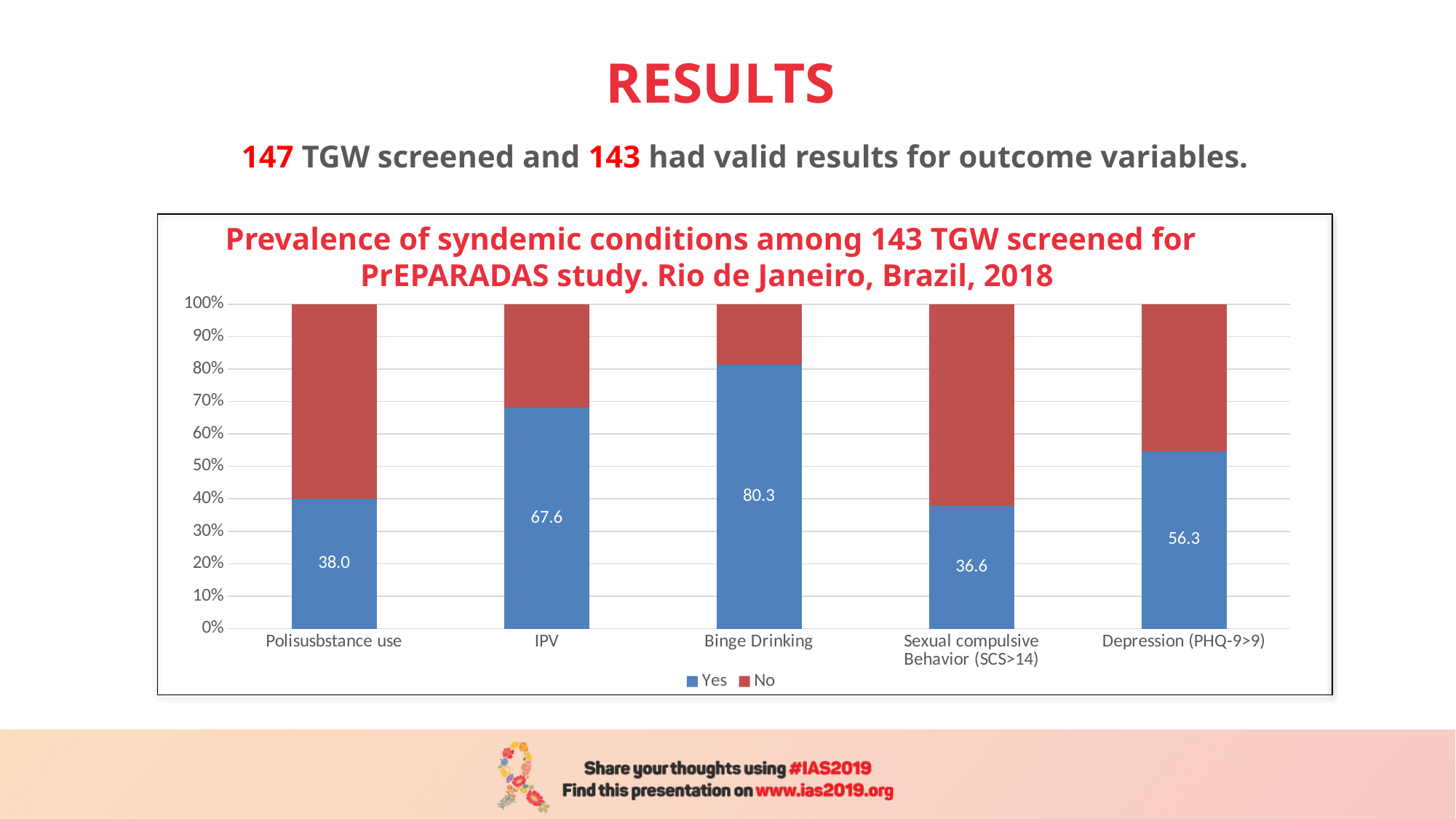
What is the 'Yes' value for Depression (PHQ-9>9)? 56.3 What is the 'Yes' value for Binge Drinking? 80.3 What is the difference between the 'Yes' values for Binge Drinking and IPV? 12.7 Which condition has the highest 'Yes' value? Binge Drinking What is the 'Yes' value for Polisusbstance use? 38.0 What is the 'Yes' value for IPV? 67.6 Is the 'No' share for Sexual compulsive Behavior (SCS>14) greater or less than 50%? greater Which has a larger 'Yes' value, Depression (PHQ-9>9) or Polisusbstance use? Depression (PHQ-9>9) Which condition has the lowest 'Yes' value? Sexual compulsive Behavior (SCS>14) How many series does the legend list? 2 How many conditions are shown on the x axis? 5 What kind of chart is shown? Stacked bar chart